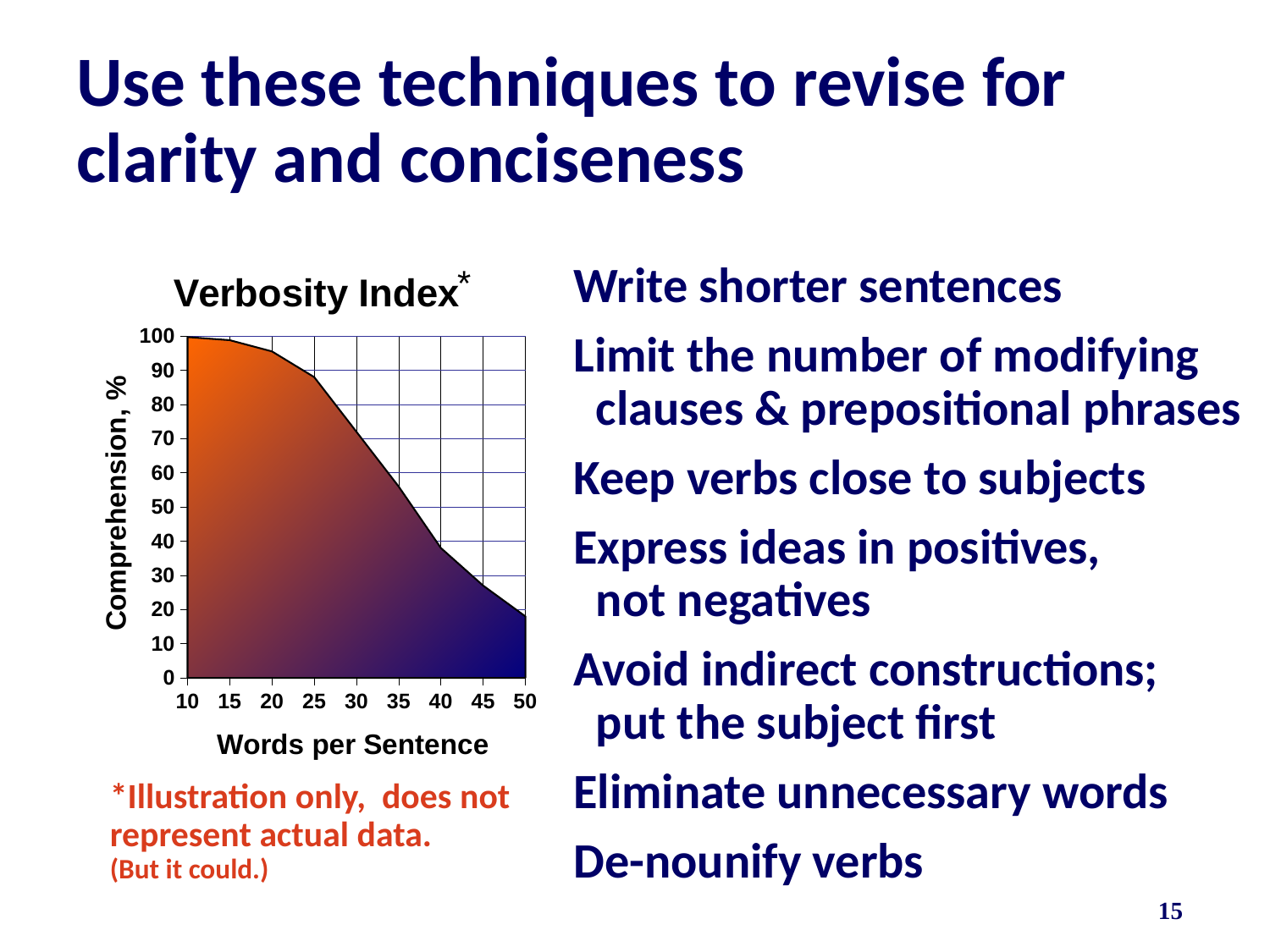
Is the Comprehension value at 50 words per sentence greater or less than 20? less At which Words per Sentence value is Comprehension highest? 10 Which has higher Comprehension: 15 words per sentence or 45 words per sentence? 15 words per sentence What kind of chart is shown on the slide? area chart Is the Comprehension value at 40 words per sentence greater or less than 50? less Is the Comprehension value at 25 words per sentence greater or less than 80? greater What is the title of the chart? Verbosity Index How many Words per Sentence tick values are shown on the x axis? 9 At which Words per Sentence value is Comprehension lowest? 50 Do the values rise or fall as Words per Sentence increases along the x axis? fall What is the label of the y axis of the chart? Comprehension, %